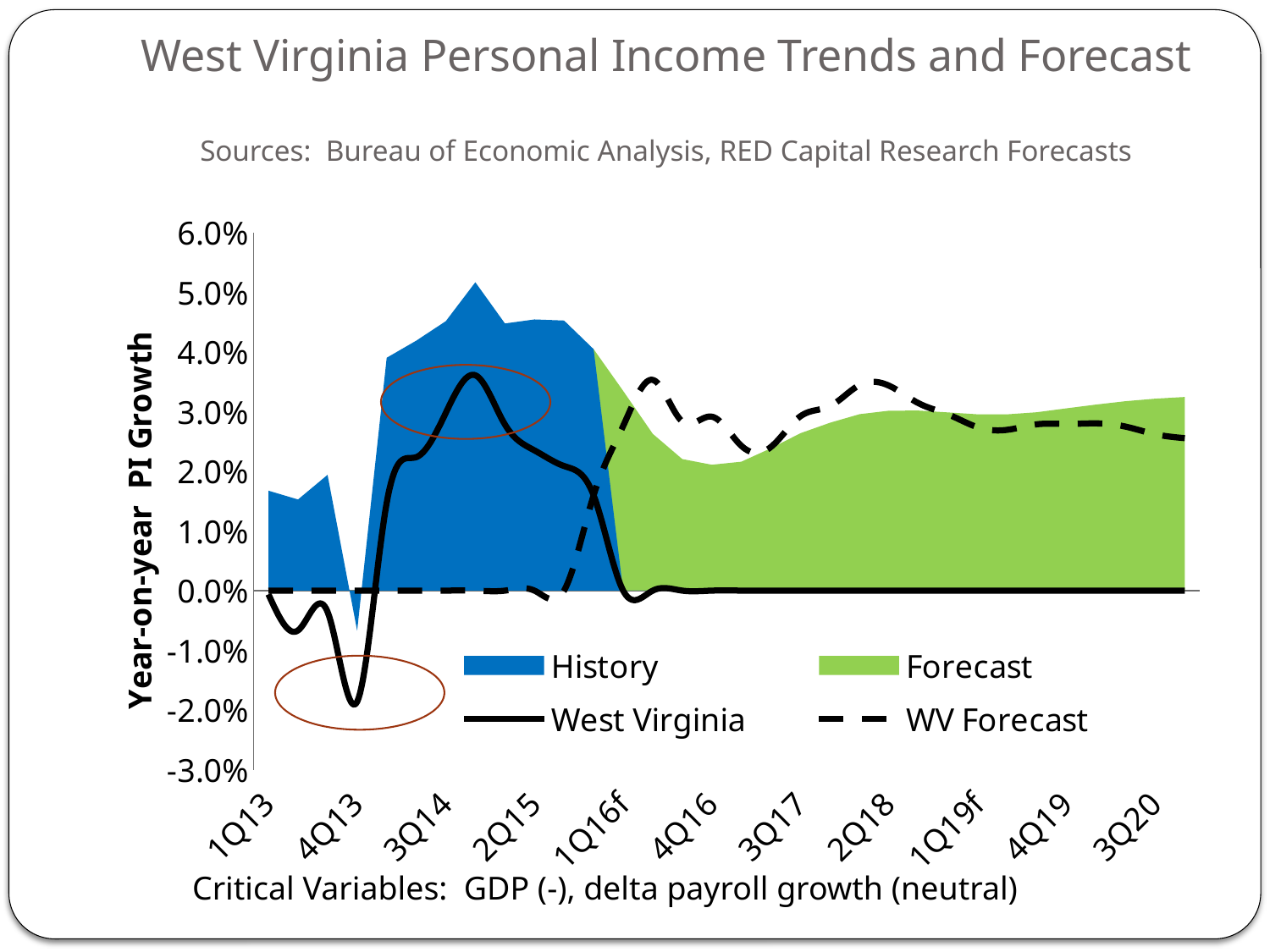
What is the title of the chart? West Virginia Personal Income Trends and Forecast What kind of chart is this? Area chart with line series Is the value of the WV Forecast line at 3Q20 greater or less than 3.0%? less What is the label on the vertical axis? Year-on-year PI Growth Is the peak of the West Virginia line, near 3Q14, greater or less than 3.0%? greater Which is larger: the peak of the History area or the peak of the Forecast area? History How many series does the legend list? 4 How many labels are shown on the horizontal axis? 11 Is the value of the History area at 1Q13 greater or less than 1.0%? greater Does the Forecast area rise or fall from 4Q16 to 3Q20? rise